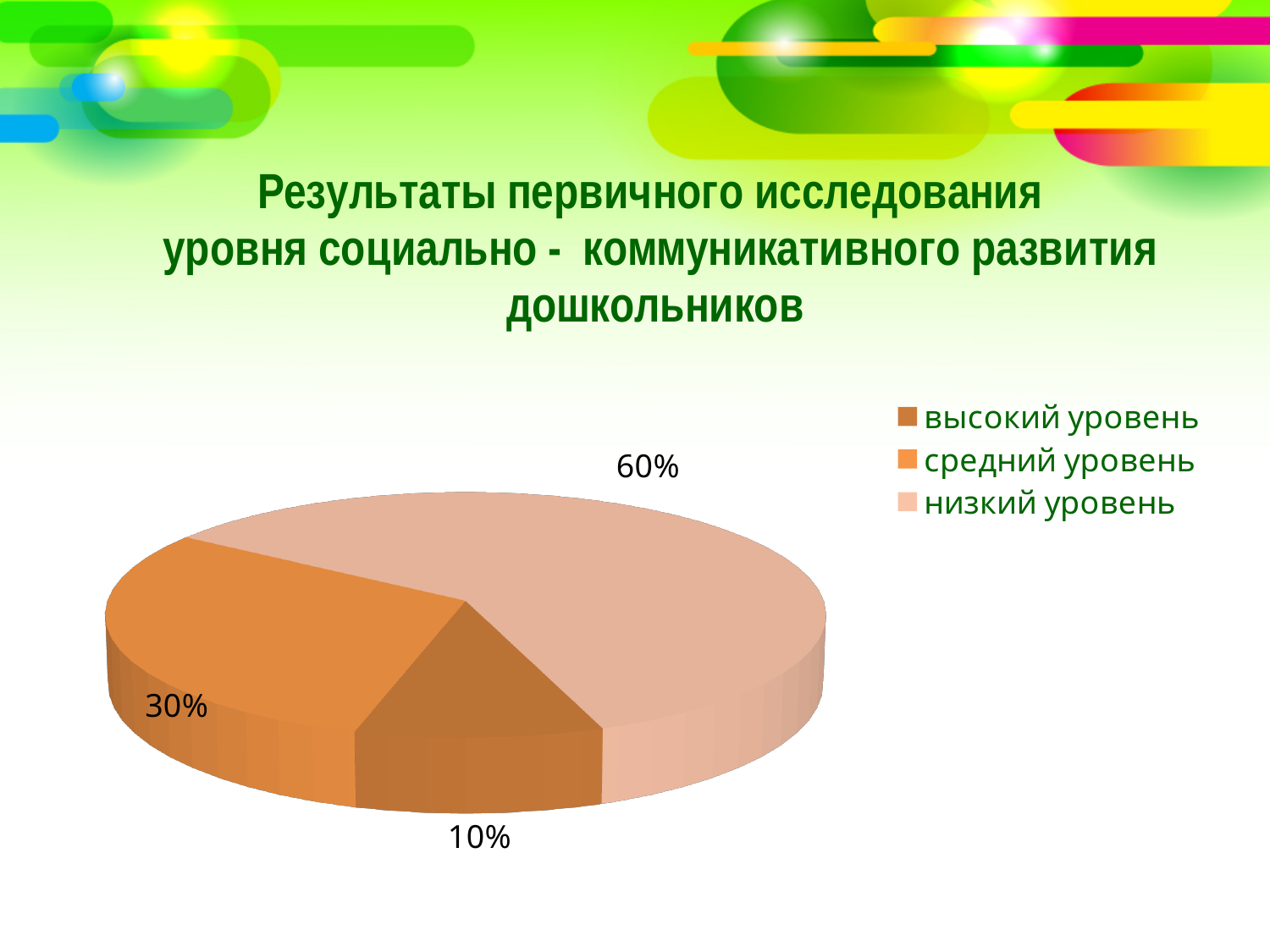
Which legend entry is shown in the lightest colour? низкий уровень What share of the pie does "средний уровень" take? 30% Which is larger, the share of "средний уровень" or the share of "высокий уровень"? средний уровень How many slices does the pie chart have? 3 Which category has the smallest slice of the pie? высокий уровень What is the difference between the shares of "низкий уровень" and "средний уровень"? 30% What share of the pie does "низкий уровень" take? 60% What is the difference between the shares of "средний уровень" and "высокий уровень"? 20% How many entries does the legend list? 3 Which category has the largest slice of the pie? низкий уровень What share of the pie does "высокий уровень" take? 10% What kind of chart is shown on the slide? pie chart